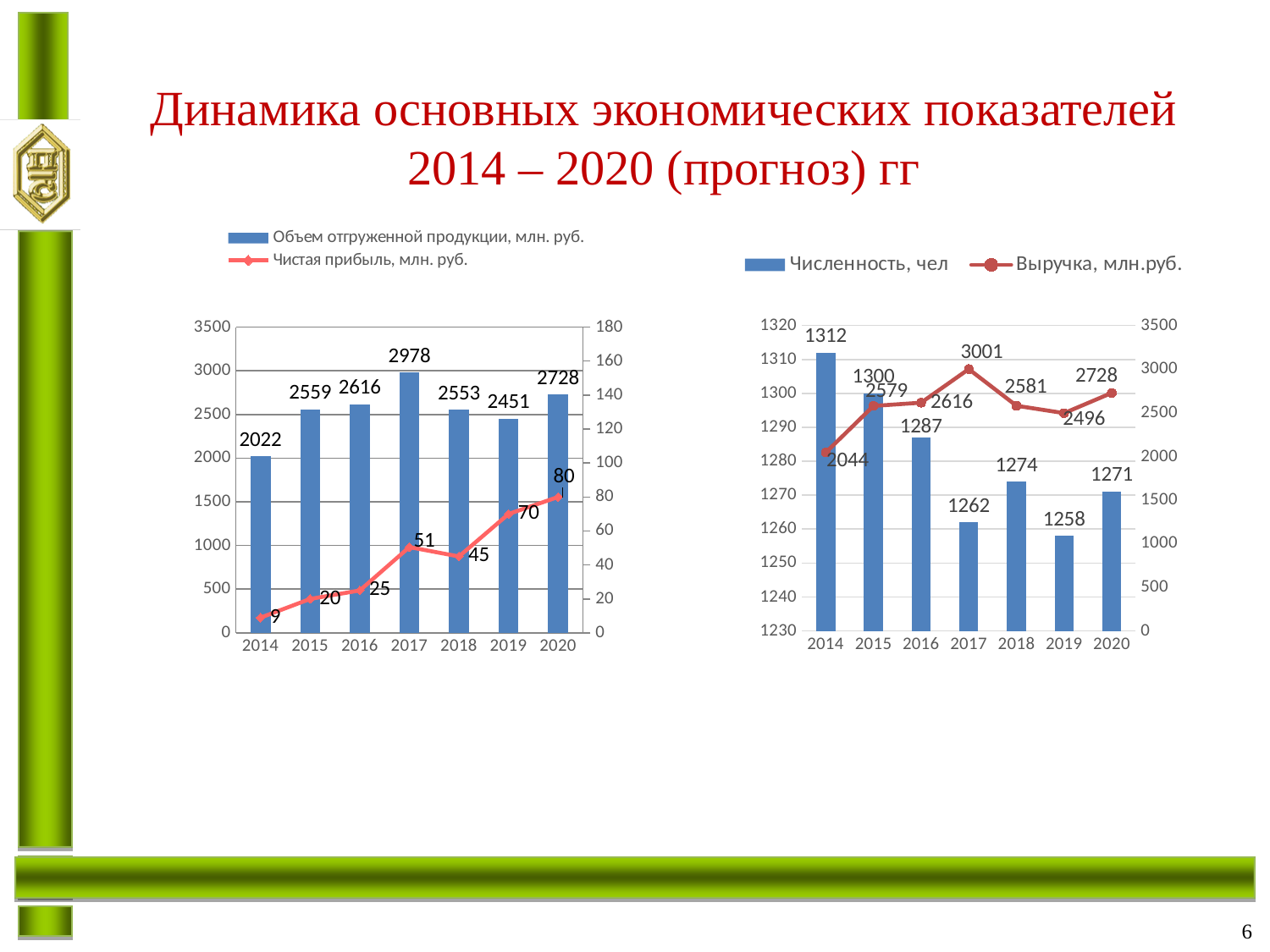
In the right chart, which year has the lowest Численность? 2019 In the right chart, what is the Численность value for 2016? 1287 How many years are shown on the x axis of the right chart? 7 In the right chart, what is the difference between the Численность values for 2014 and 2020? 41 In the left chart, what is the Чистая прибыль value for 2019? 70 In the right chart, which year has the highest Выручка? 2017 In the left chart, what is the value of Объем отгруженной продукции for 2017? 2978 In the left chart, how many series does the legend list? 2 In the left chart, what is the difference between the Чистая прибыль values for 2020 and 2014? 71 In the right chart, what is the Выручка value for 2017? 3001 In the left chart, does the Чистая прибыль line generally rise or fall from 2014 to 2020? rise In the left chart, which year has the lowest Объем отгруженной продукции? 2014